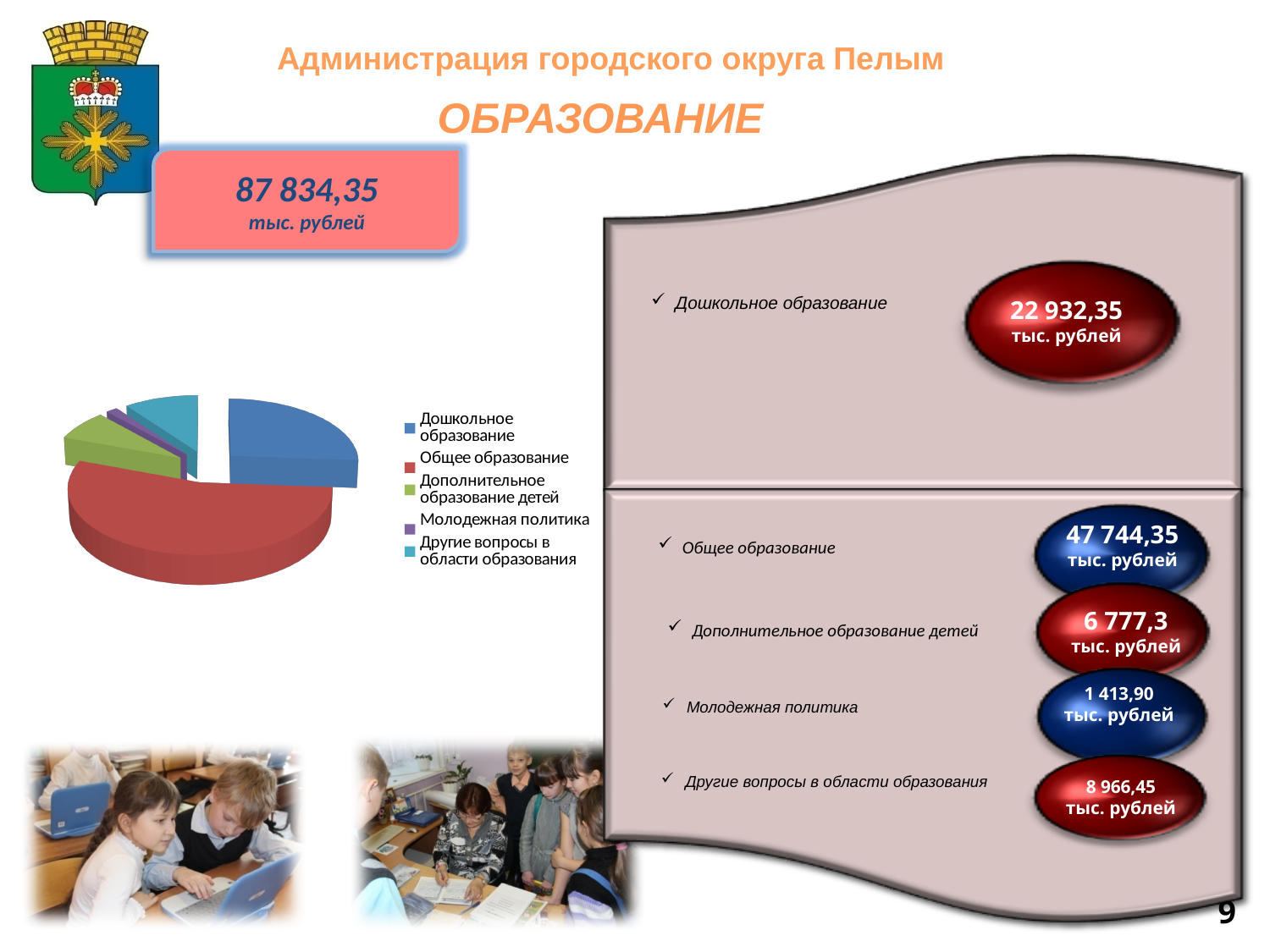
Which category has the smallest slice in the pie chart? Молодежная политика What value is shown on the slide for Дошкольное образование? 22 932,35 тыс. рублей What value is shown on the slide for Общее образование? 47 744,35 тыс. рублей What kind of chart is shown on the slide? Pie chart How many categories does the pie chart show? 5 What value is shown on the slide for Другие вопросы в области образования? 8 966,45 тыс. рублей Which slice is larger in the pie chart: Дошкольное образование or Дополнительное образование детей? Дошкольное образование Which category has the largest slice in the pie chart? Общее образование What value is shown on the slide for Молодежная политика? 1 413,90 тыс. рублей By how much does the value for Общее образование exceed the value for Дошкольное образование? 24 812,00 тыс. рублей How many entries does the pie chart's legend list? 5 What colour is the Общее образование slice in the pie chart? Red